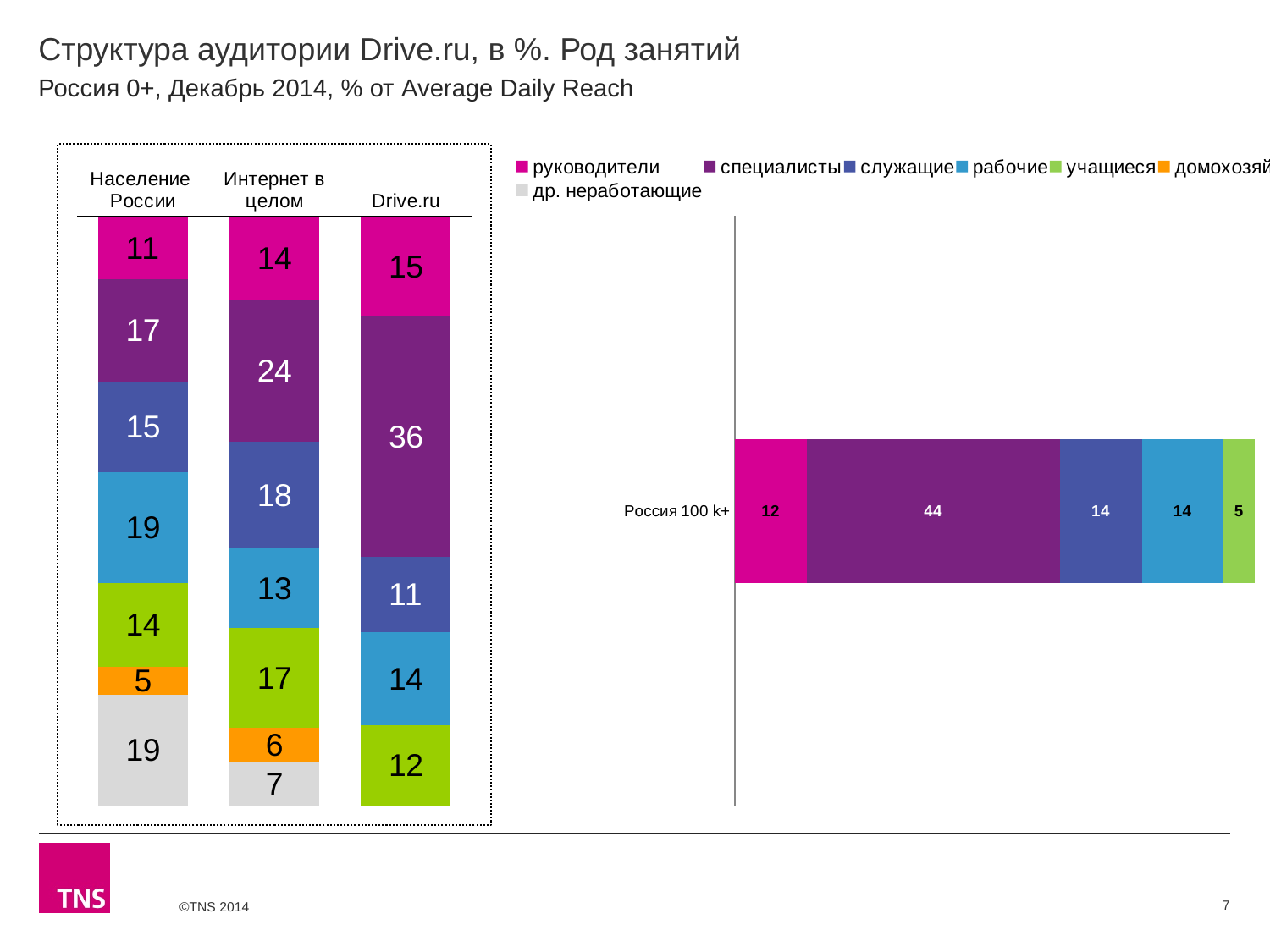
In the left chart, what is the value for учащиеся in the Интернет в целом column? 17 What type of chart is the right chart? Stacked bar chart In the right chart, what is the value for специалисты for Россия 100 k+? 44 In the left chart, which segment is the smallest in the Население России column? домохозяйки (5) In the left chart, what is the difference between the специалисты values for Drive.ru and Интернет в целом? 12 In the left chart, which is larger: руководители for Drive.ru or руководители for Население России? Drive.ru In the right chart, what is the value for учащиеся for Россия 100 k+? 5 In the left chart, which segment is the largest in the Drive.ru column? специалисты In the left chart, how many columns (audiences) are shown? 3 In the left chart, what is the value for специалисты in the Drive.ru column? 36 In the left chart, what is the value for рабочие in the Население России column? 19